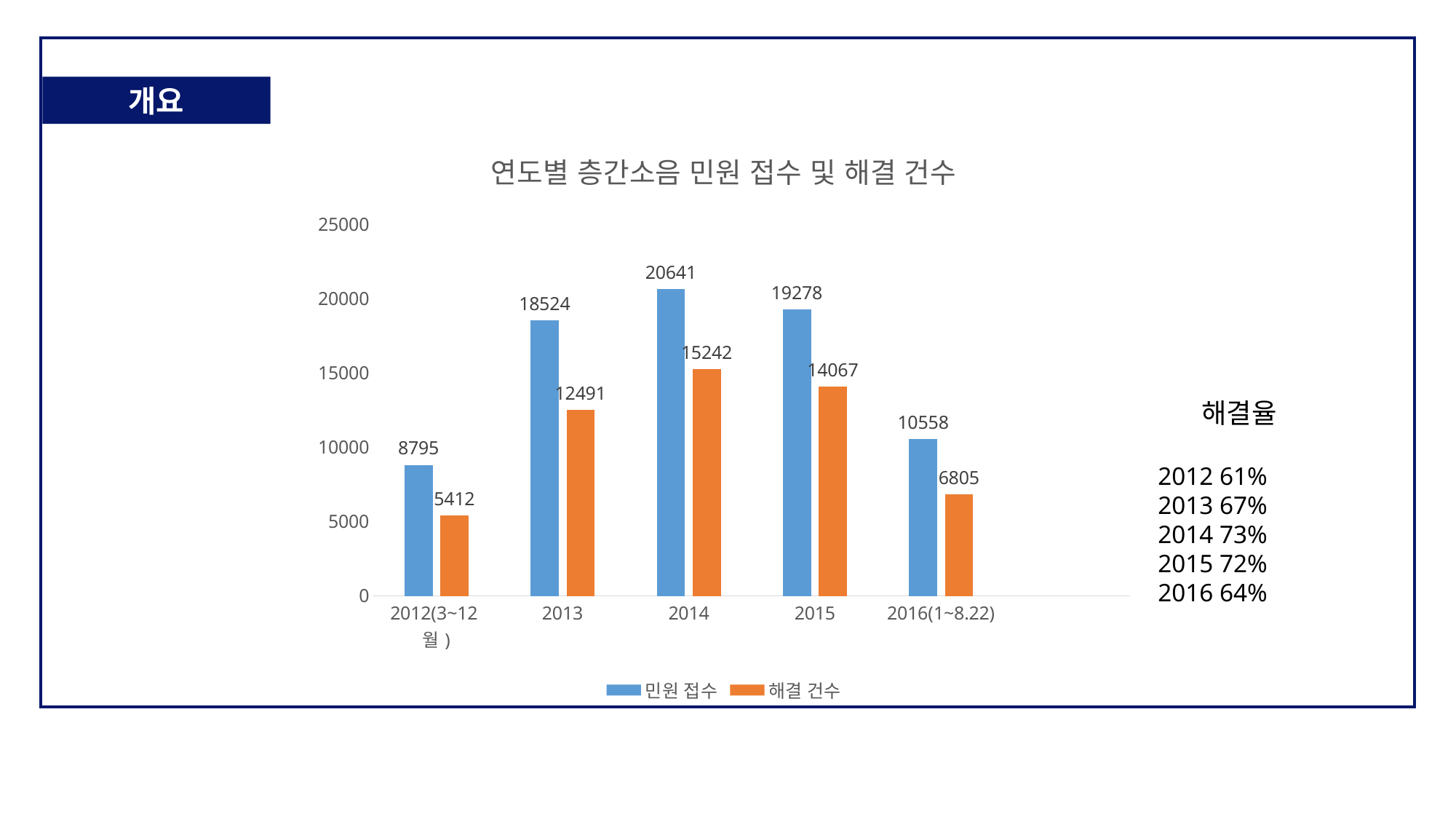
Which category has the highest 민원 접수 value? 2014 Which category has the lowest 해결 건수 value? 2012(3~12월) How many categories are shown on the x axis? 5 What is the title of the chart? 연도별 층간소음 민원 접수 및 해결 건수 What is the value of 해결 건수 for 2016(1~8.22)? 6805 What is the value of 민원 접수 for 2014? 20641 What kind of chart is shown on the slide? bar chart Is the value of 해결 건수 for 2014 greater or less than 15000? greater What is the value of 해결 건수 for 2013? 12491 Which is larger: 민원 접수 for 2013 or 민원 접수 for 2015? 2015 How many series does the legend list? 2 What is the difference between 민원 접수 and 해결 건수 for 2015? 5211